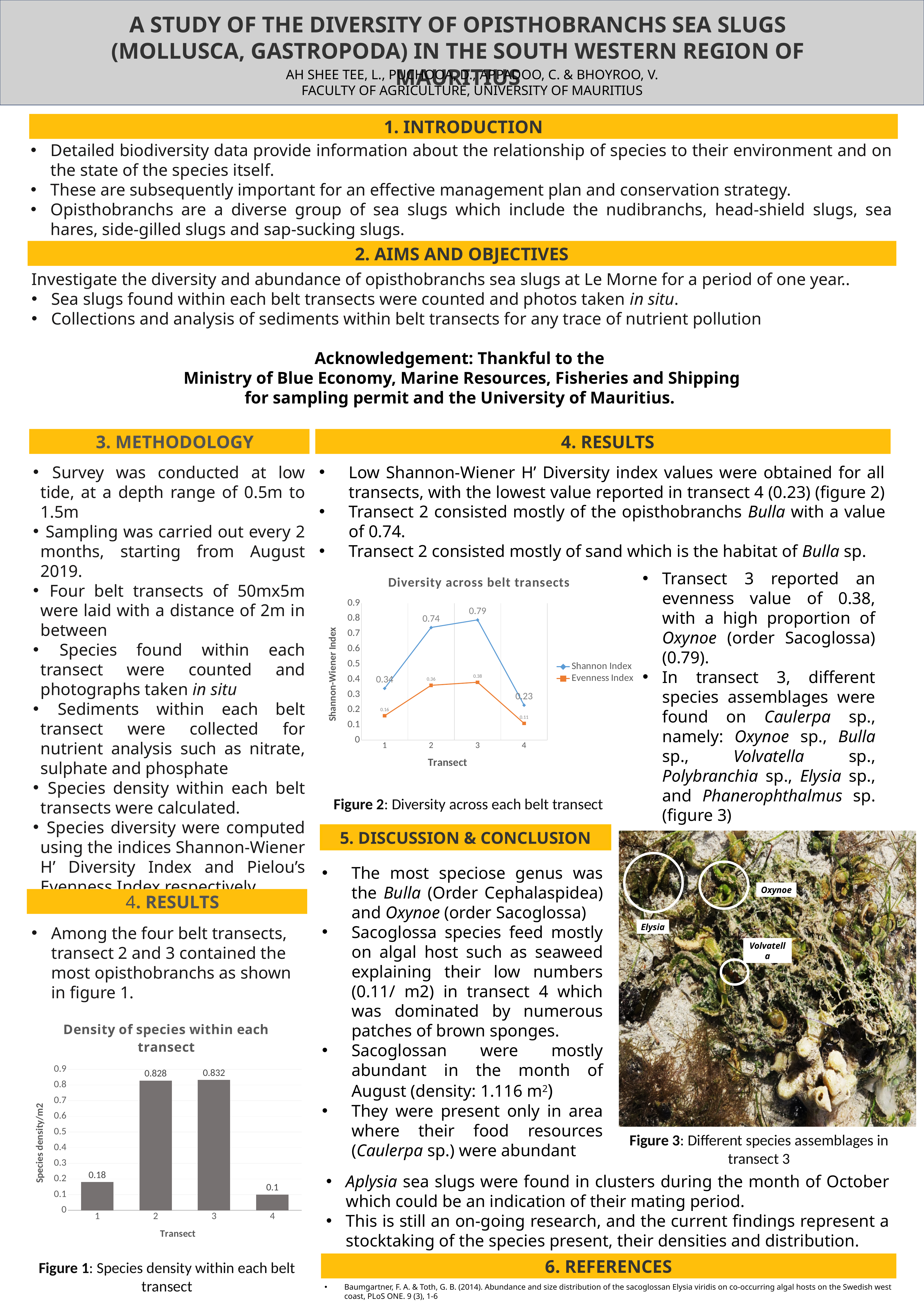
In the 'Density of species within each transect' chart, is the value for transect 2 greater or less than 0.5? greater In the 'Diversity across belt transects' chart, how many series does the legend list? 2 In the 'Diversity across belt transects' chart, what is the Shannon Index value for transect 2? 0.74 In the 'Density of species within each transect' chart, what is the species density for transect 1? 0.18 In the 'Diversity across belt transects' chart, which transect has the lowest Evenness Index? 4 What kind of chart is 'Diversity across belt transects'? Line chart In the 'Density of species within each transect' chart, which transect has the lowest species density? 4 How many transects are shown in the 'Density of species within each transect' chart? 4 In the 'Diversity across belt transects' chart, which transect has the highest Shannon Index? 3 In the 'Diversity across belt transects' chart, what is the Evenness Index value for transect 3? 0.38 In the 'Diversity across belt transects' chart, what is the difference between the Shannon Index values for transect 3 and transect 4? 0.56 What kind of chart is 'Density of species within each transect'? Bar chart